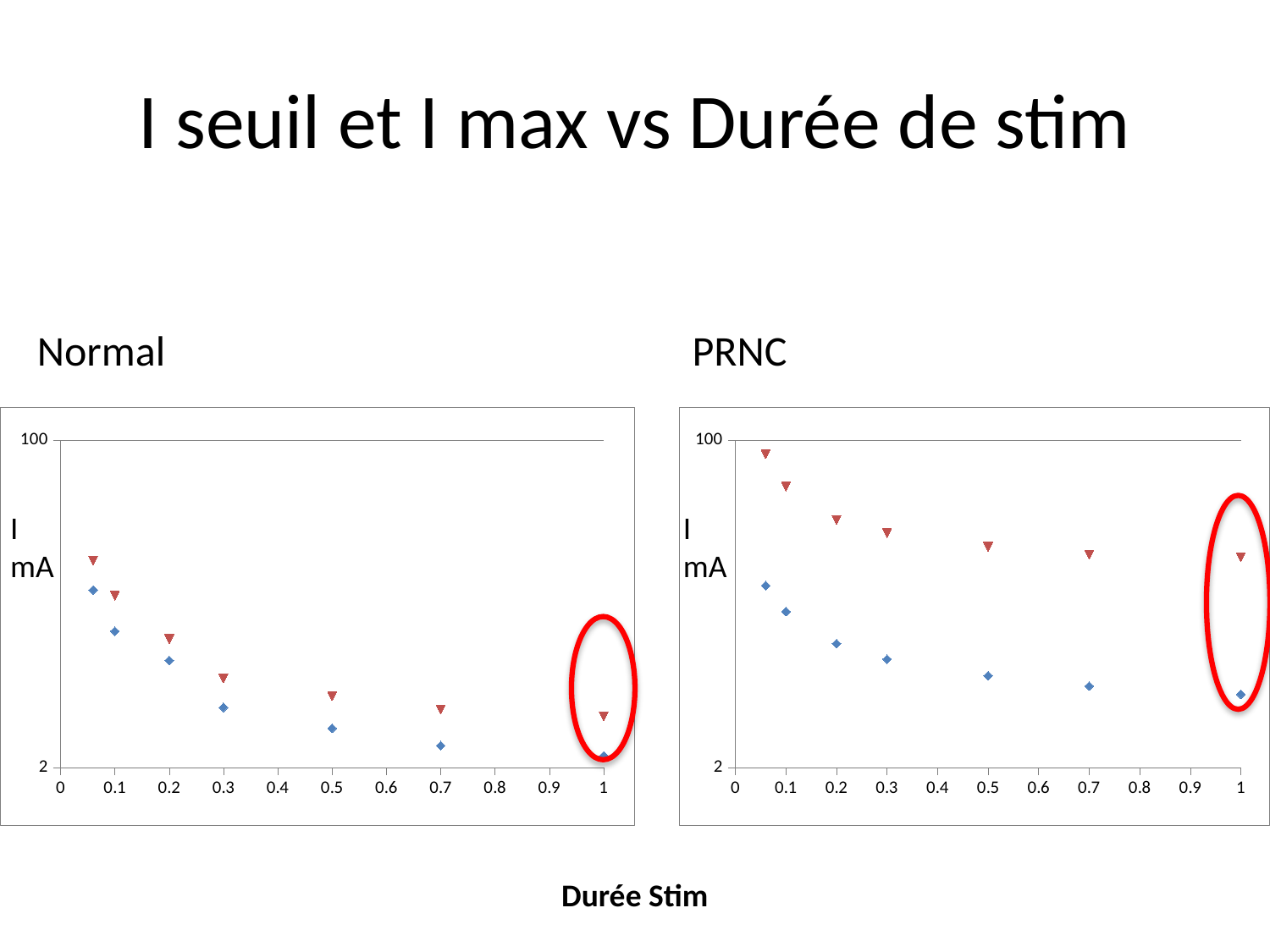
In the PRNC chart, at Durée Stim 0.5, which is larger: the blue diamond value or the red triangle value? red triangle In the PRNC chart, do the red triangle values rise or fall as Durée Stim increases from 0.1 to 0.7? fall In the Normal chart, how many blue diamond points are plotted? 7 In the Normal chart, at Durée Stim 0.3, which is larger: the red triangle value or the blue diamond value? red triangle In the PRNC chart, how many red triangle points are plotted? 7 What is the x-axis label shared by the two charts? Durée Stim In the Normal chart, at which Durée Stim value is the blue diamond value lowest? 1 What is the highest value shown on the y axis of the PRNC chart? 100 At Durée Stim 1, is the red triangle value larger in the Normal chart or in the PRNC chart? PRNC What kind of chart is the Normal chart? scatter chart In the Normal chart, do the blue diamond values rise or fall as Durée Stim increases from 0.1 to 1? fall